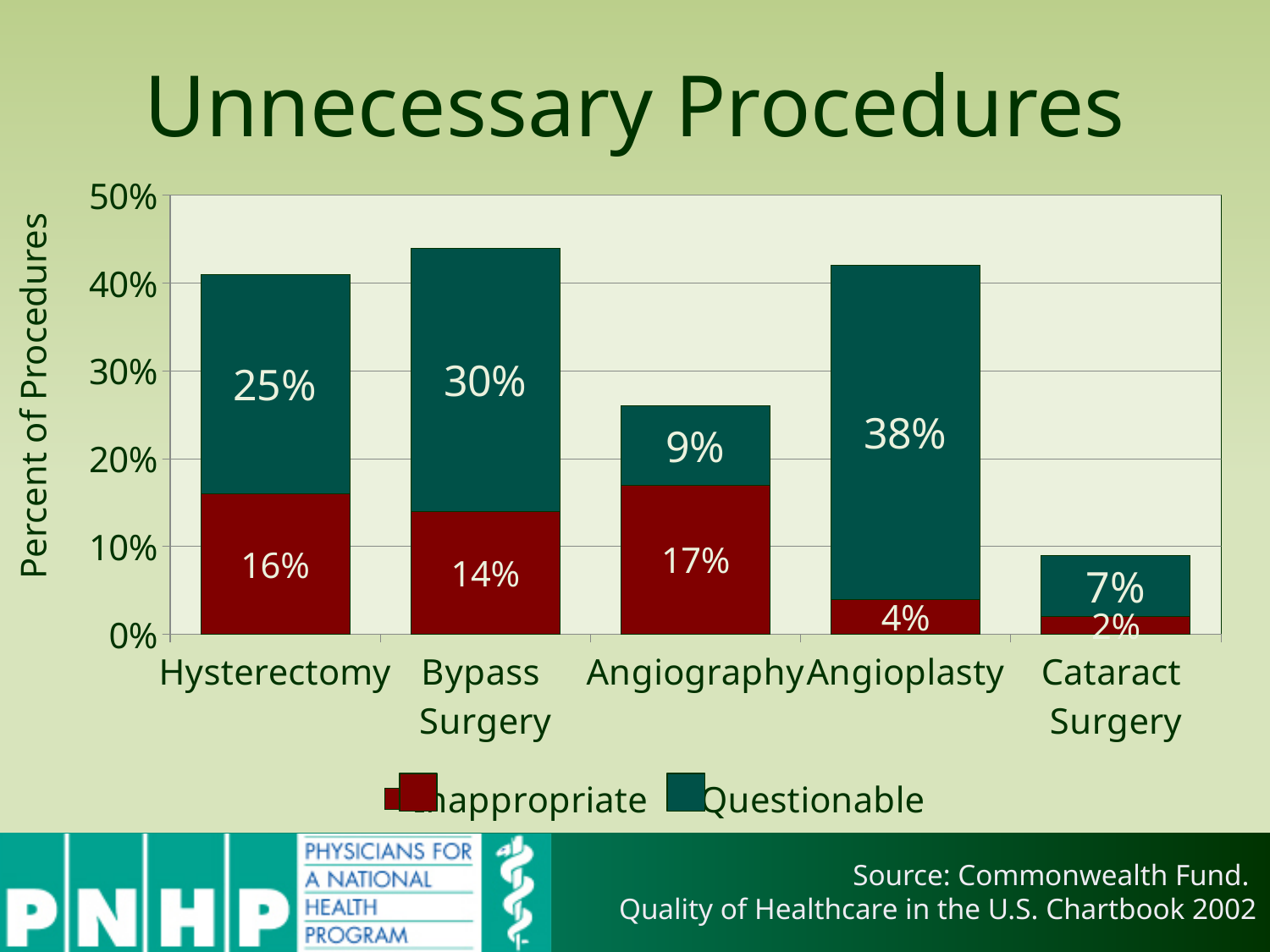
What is the total of the stacked bar for Cataract Surgery? 9% What is the Inappropriate value for Angiography? 17% How many series does the legend list? 2 Which procedure has the highest Questionable value? Angioplasty What is the Questionable value for Angioplasty? 38% What kind of chart is shown on the slide? Stacked bar chart What is the difference between the Questionable values for Bypass Surgery and Hysterectomy? 5% Which is larger, the Inappropriate value for Hysterectomy or for Bypass Surgery? Hysterectomy How many procedures are shown on the x axis? 5 Which procedure has the lowest Inappropriate value? Cataract Surgery What is the total of the stacked bar for Bypass Surgery? 44% What is the Inappropriate value for Cataract Surgery? 2%